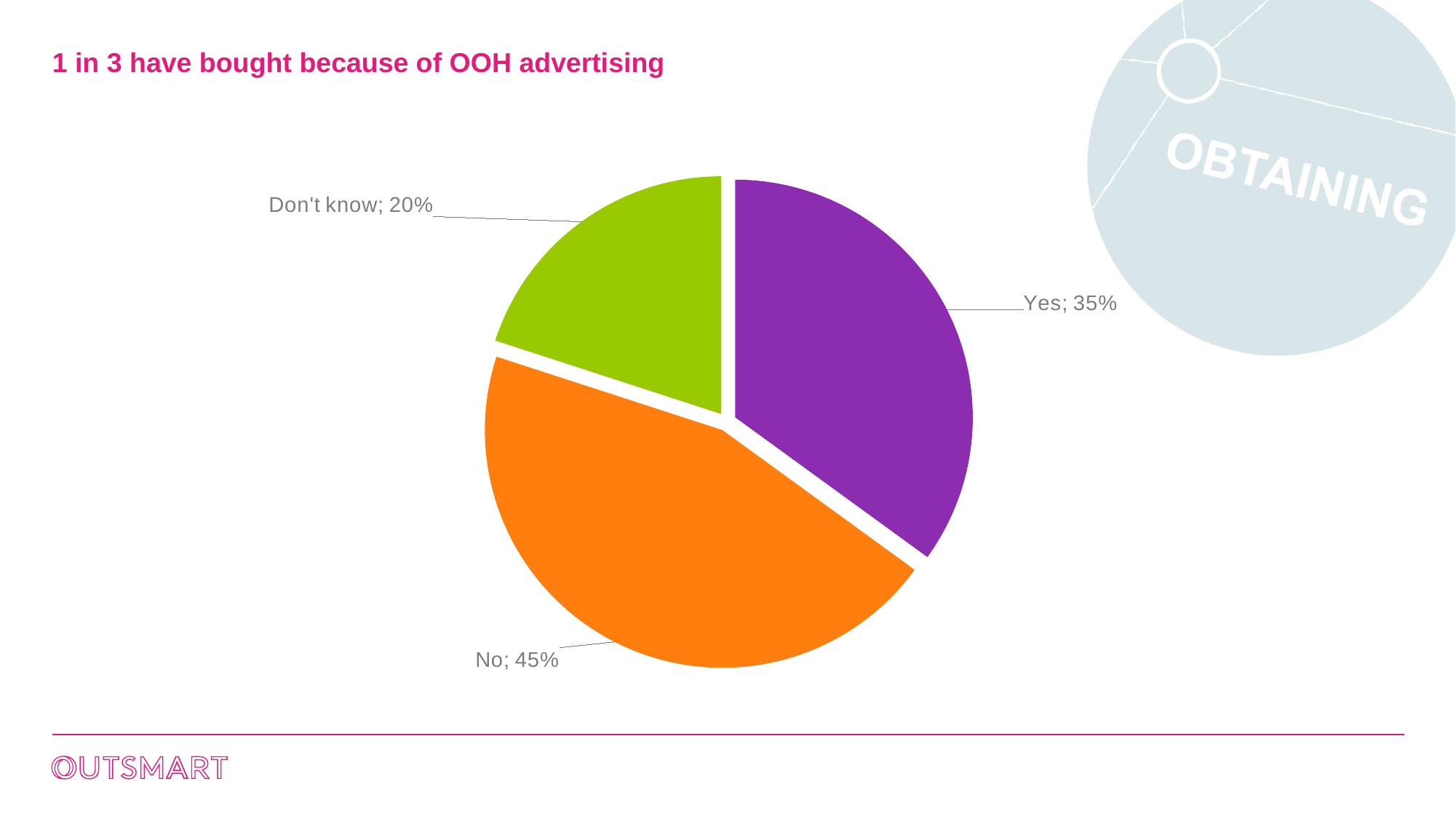
Which response has the smallest share of the pie? Don't know What type of chart is shown on the slide? Pie chart Which is larger, the "Yes" slice or the "Don't know" slice? Yes What is the title of the slide? 1 in 3 have bought because of OOH advertising Which response has the largest share of the pie? No What colour is the "No" slice? Orange What percentage of respondents answered "No"? 45% What is the difference in percentage points between the "Yes" and "Don't know" slices? 15 How many slices does the pie chart have? 3 What is the difference in percentage points between the "No" and "Yes" slices? 10 What percentage of respondents answered "Yes"? 35% What percentage of respondents answered "Don't know"? 20%